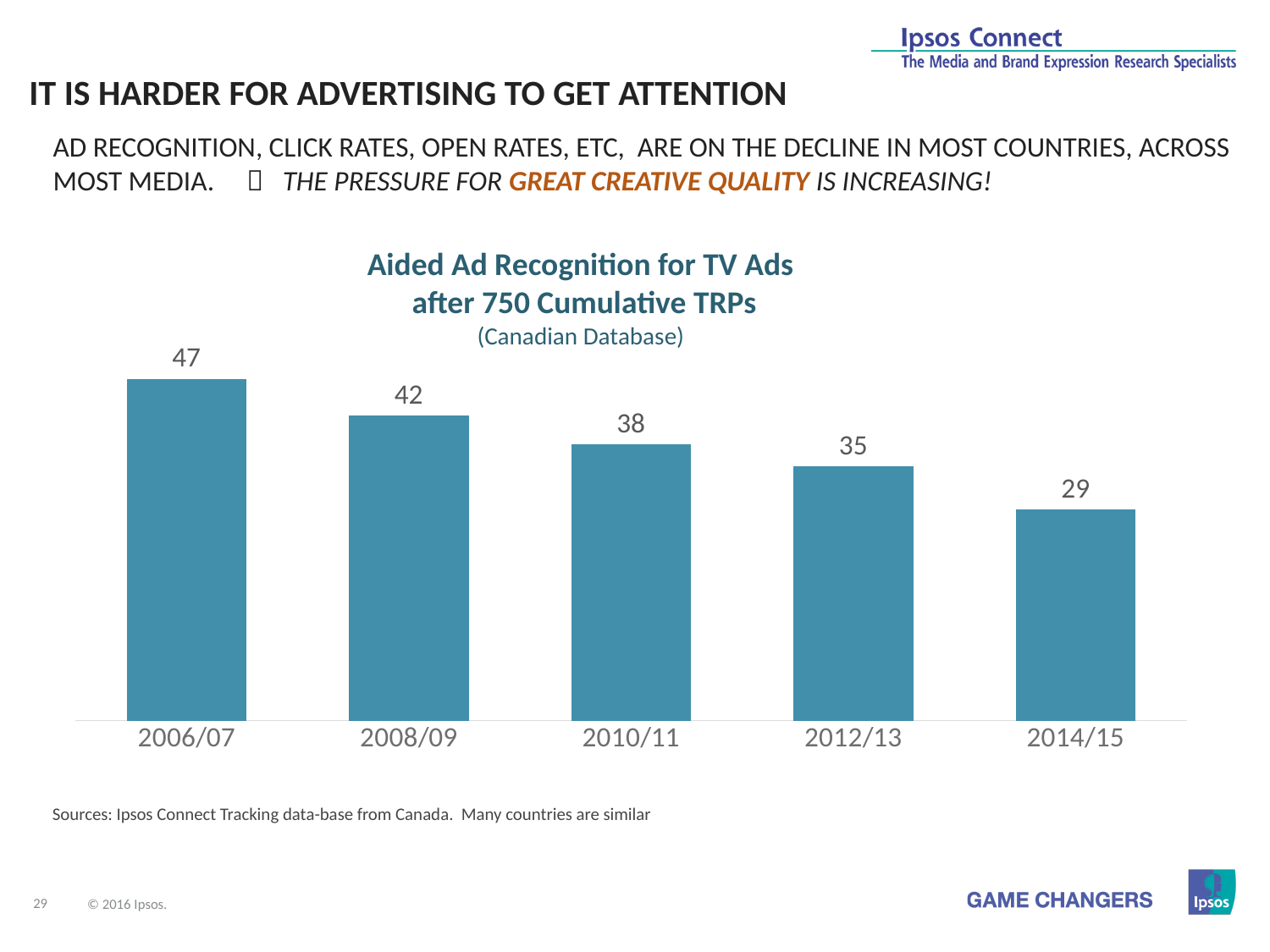
Which period has the highest aided ad recognition? 2006/07 What is the title of the chart? Aided Ad Recognition for TV Ads after 750 Cumulative TRPs What is the aided ad recognition value for 2014/15? 29 How many periods are shown on the chart? 5 What is the value shown for 2010/11? 38 What is the difference between the values for 2006/07 and 2014/15? 18 What is the difference between the values for 2008/09 and 2012/13? 7 Do the values rise or fall from 2006/07 to 2014/15? Fall What is the aided ad recognition value for 2006/07? 47 Which period has the lowest aided ad recognition? 2014/15 What kind of chart is shown on the slide? Bar chart Which is larger, the value for 2008/09 or the value for 2012/13? 2008/09